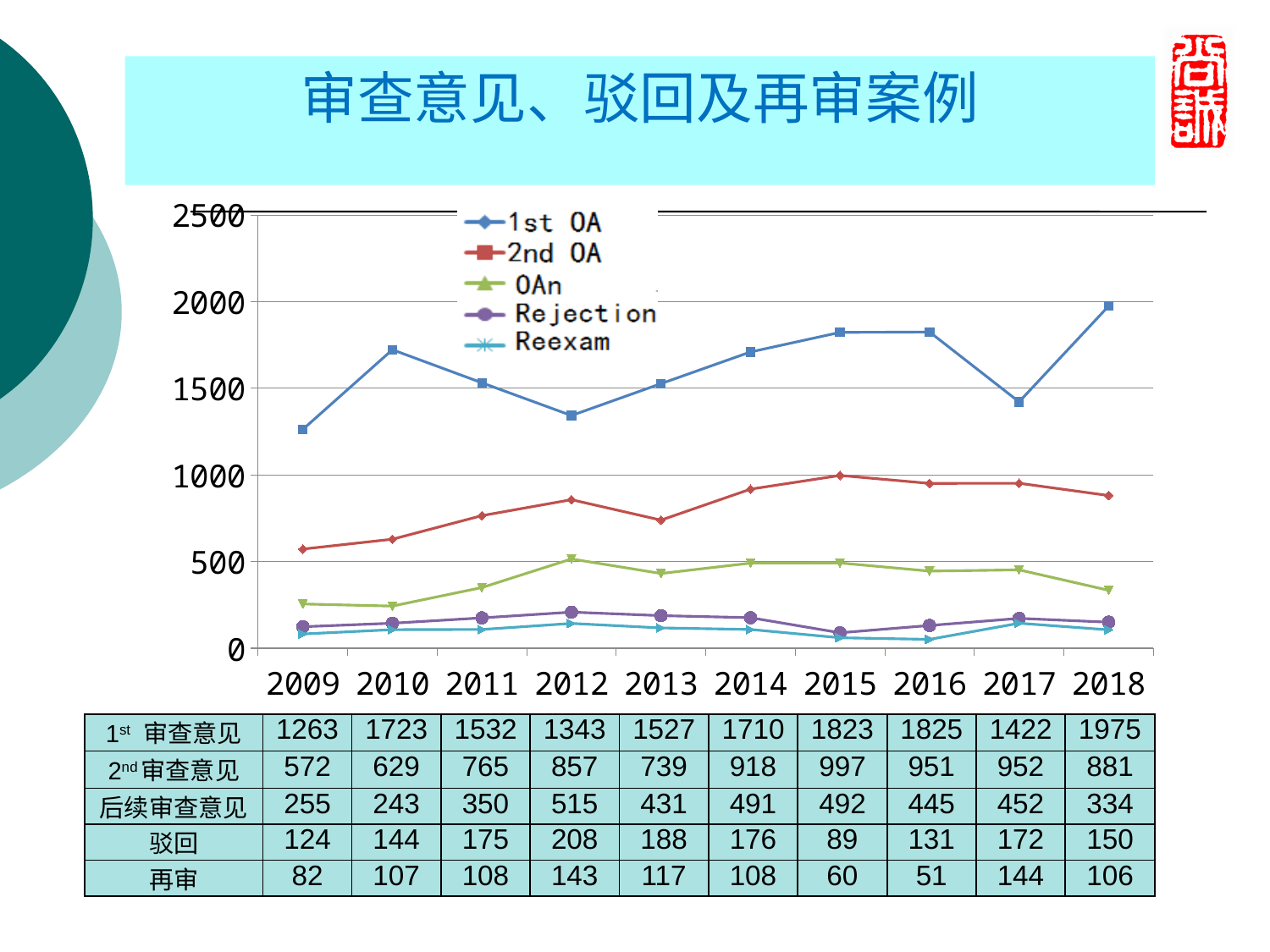
What kind of chart is shown on the slide? line chart How many series does the chart legend list? 5 According to the data table, what is the 1st OA value for 2018? 1975 According to the data table, what is the Rejection (驳回) value for 2012? 208 According to the data table, what is the 2nd OA value for 2015? 997 In which year is the Reexam (再审) series at its lowest value? 2016 Which is larger in 2013: the 2nd OA value or the OAn value? 2nd OA What is the difference between the 1st OA values for 2018 and 2017? 553 Which series is drawn with the red line and square markers? 2nd OA In which year does the 1st OA series reach its highest value? 2018 How many years are plotted along the x axis of the chart? 10 Is the 1st OA value for 2012 greater or less than 1500? less